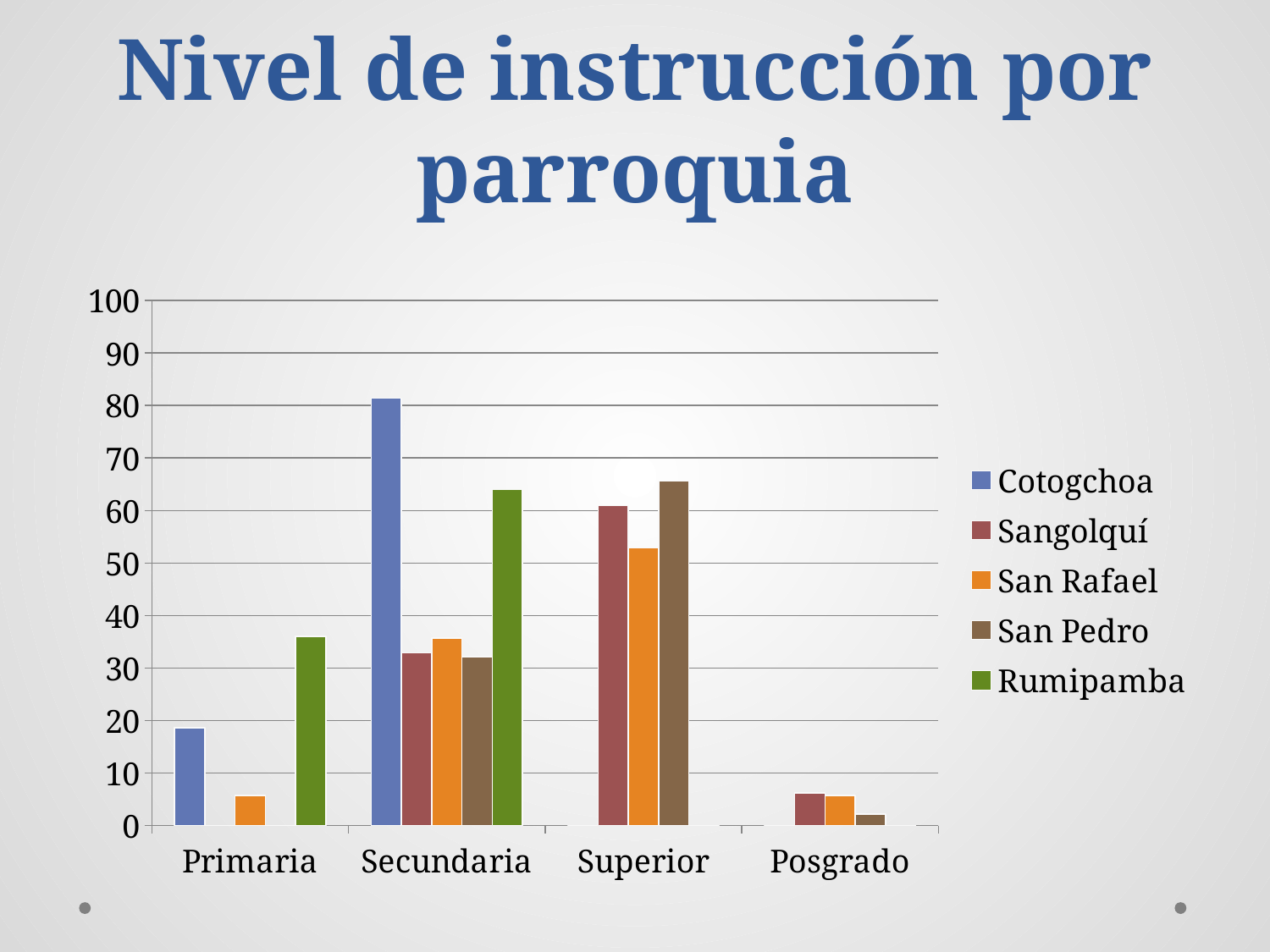
How many education-level categories are shown on the x axis? 4 In the Primaria category, which is larger: Cotogchoa or San Rafael? Cotogchoa Which parroquia has the highest value in the Superior category? San Pedro Which parroquia has the highest value in the Secundaria category? Cotogchoa In the Secundaria category, which is larger: Rumipamba or Sangolquí? Rumipamba What is the title of the chart on the slide? Nivel de instrucción por parroquia Is the value for Cotogchoa in Secundaria greater or less than 70? greater How many series does the legend list? 5 Is the value for San Pedro in Superior greater or less than 60? greater Is the value for San Rafael in Superior greater or less than 50? greater What kind of chart is shown on the slide? bar chart